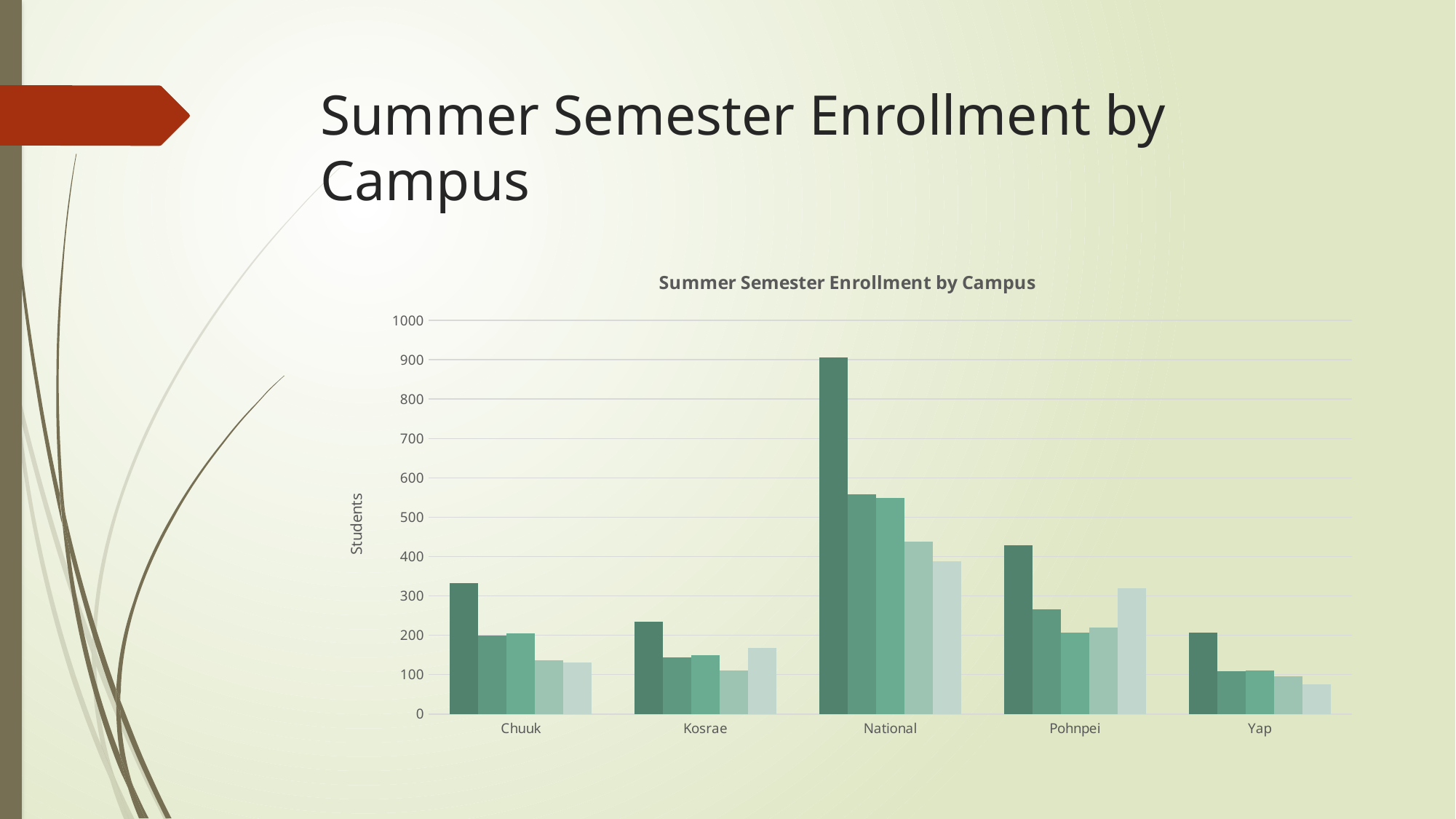
What kind of chart is shown on the slide? bar chart Is the tallest bar for Kosrae greater or less than 300? less Which campus has the shortest bar in the chart? Yap Is the tallest bar for National greater or less than 800? greater Which campus has the tallest bar in the chart? National Which campus has a taller tallest bar, Chuuk or Kosrae? Chuuk What is the title of the chart? Summer Semester Enrollment by Campus What is the label on the vertical axis of the chart? Students Is the tallest bar for Chuuk greater or less than 300? greater How many campuses are shown on the x axis of the chart? 5 How many bars are plotted for each campus in the chart? 5